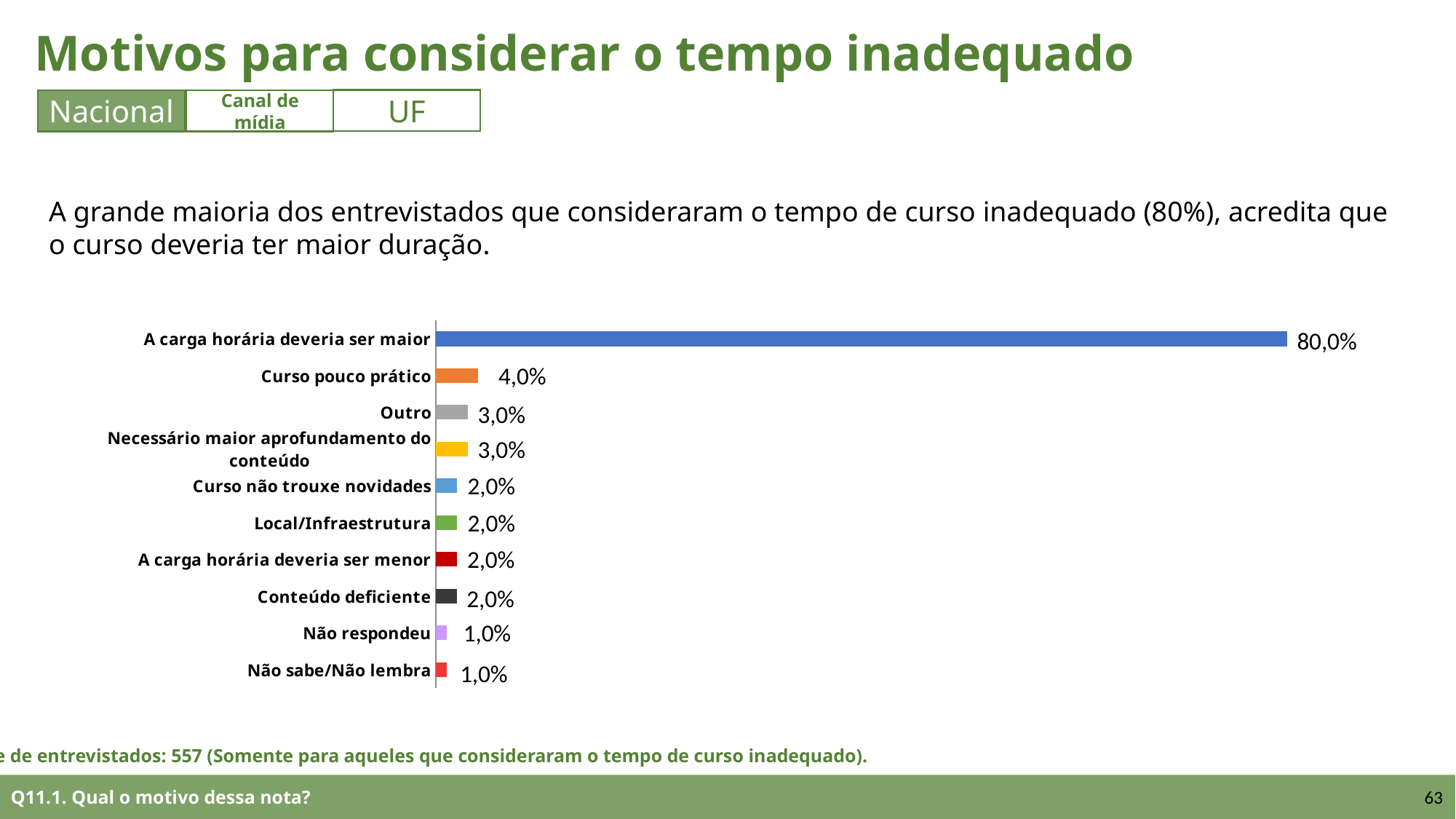
What is the value for "Curso pouco prático"? 4,0% How many categories are shown in the chart? 10 What kind of chart is shown on the slide? Bar chart What is the difference between "Curso pouco prático" and "Outro"? 1,0% What is the value for "Não respondeu"? 1,0% What colour is the bar for "A carga horária deveria ser maior"? Blue Which category has the highest value? A carga horária deveria ser maior What is the difference between "A carga horária deveria ser maior" and "Curso pouco prático"? 76,0% What is the value for "Local/Infraestrutura"? 2,0% Which is larger, "Curso pouco prático" or "Conteúdo deficiente"? Curso pouco prático What is the value for "A carga horária deveria ser maior"? 80,0% What is the value for "Necessário maior aprofundamento do conteúdo"? 3,0%